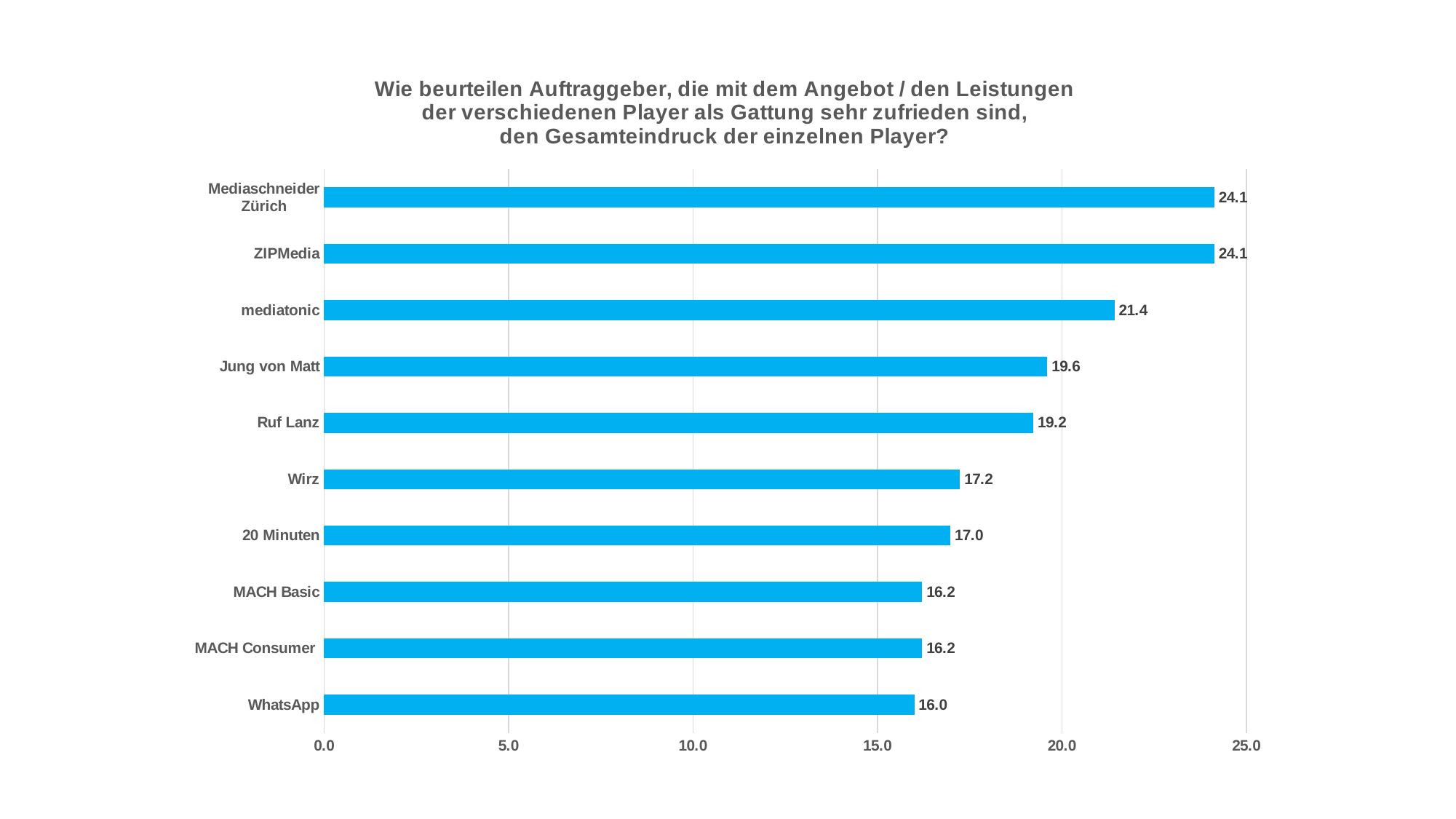
What kind of chart is shown on the slide? Bar chart What is the value for mediatonic? 21.4 Which category has the lowest value? WhatsApp Is the value for Ruf Lanz greater or less than 20.0? less What is the difference between the values for ZIPMedia and WhatsApp? 8.1 Which is larger, the value for Jung von Matt or the value for 20 Minuten? Jung von Matt What is the value for Wirz? 17.2 What is the highest value shown on the x axis? 25.0 What is the value for Jung von Matt? 19.6 How many categories are shown in the chart? 10 What is the value for WhatsApp? 16.0 What is the difference between the values for mediatonic and Ruf Lanz? 2.2